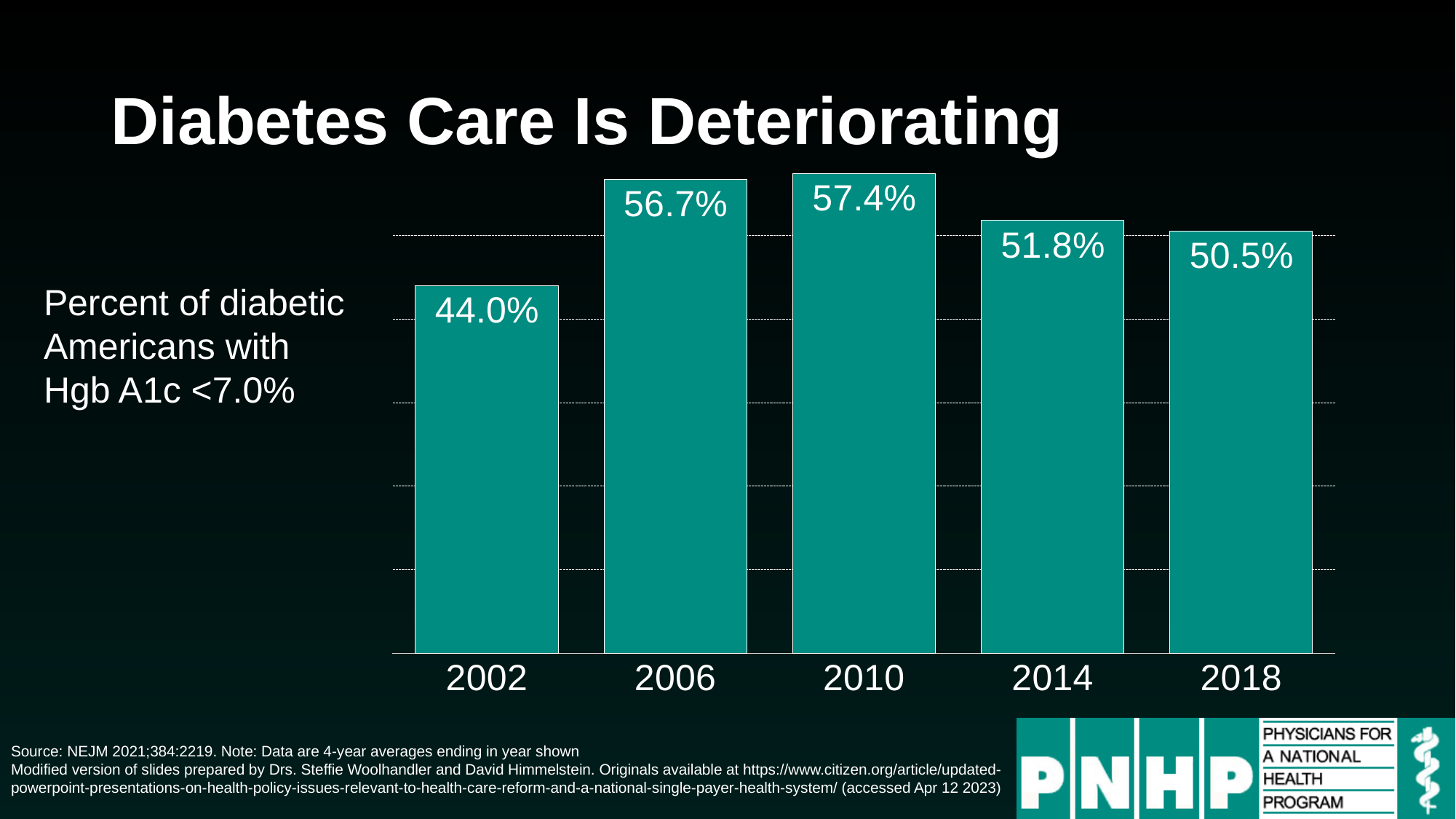
How many years are shown on the x axis? 5 What kind of chart is shown on the slide? Bar chart Do the values rise or fall from 2010 to 2018? Fall What is the value for 2018? 50.5% Which is larger, the value for 2006 or the value for 2014? 2006 What is the value for 2010? 57.4% What is the value for 2014? 51.8% Which year has the lowest value? 2002 What is the difference between the values for 2010 and 2018? 6.9% Which year has the highest value? 2010 What is the value for 2002? 44.0% What is the difference between the values for 2006 and 2002? 12.7%